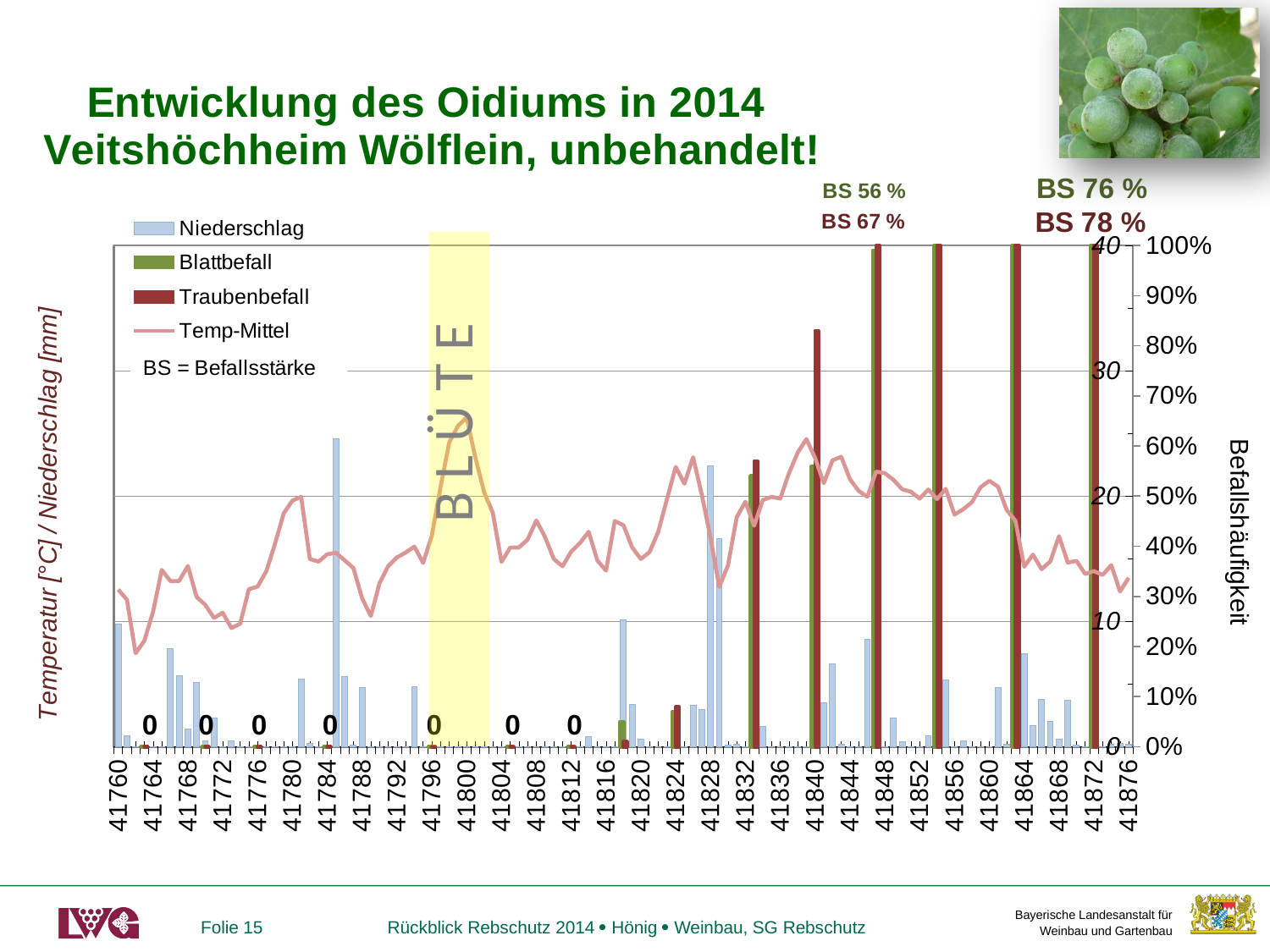
At 41840, which is larger: Traubenbefall or Blattbefall? Traubenbefall What is the title of the chart on the slide? Entwicklung des Oidiums in 2014 Veitshöchheim Wölflein, unbehandelt! According to the legend note, what does BS stand for? Befallsstärke Does the Temp-Mittel line rise or fall between 41860 and 41876? fall How many data labels reading "0" are printed along the bottom of the chart? 7 What kind of chart is shown on the slide? Combined bar and line chart Is the Traubenbefall value at 41848 greater or less than 90%? greater What is the highest value shown on the right-hand Befallshäufigkeit axis? 100% Is the Blattbefall value at 41832 greater or less than 40%? greater Is the Niederschlag bar at 41784 greater or less than 20 on the left axis? greater How many series does the chart legend list? 4